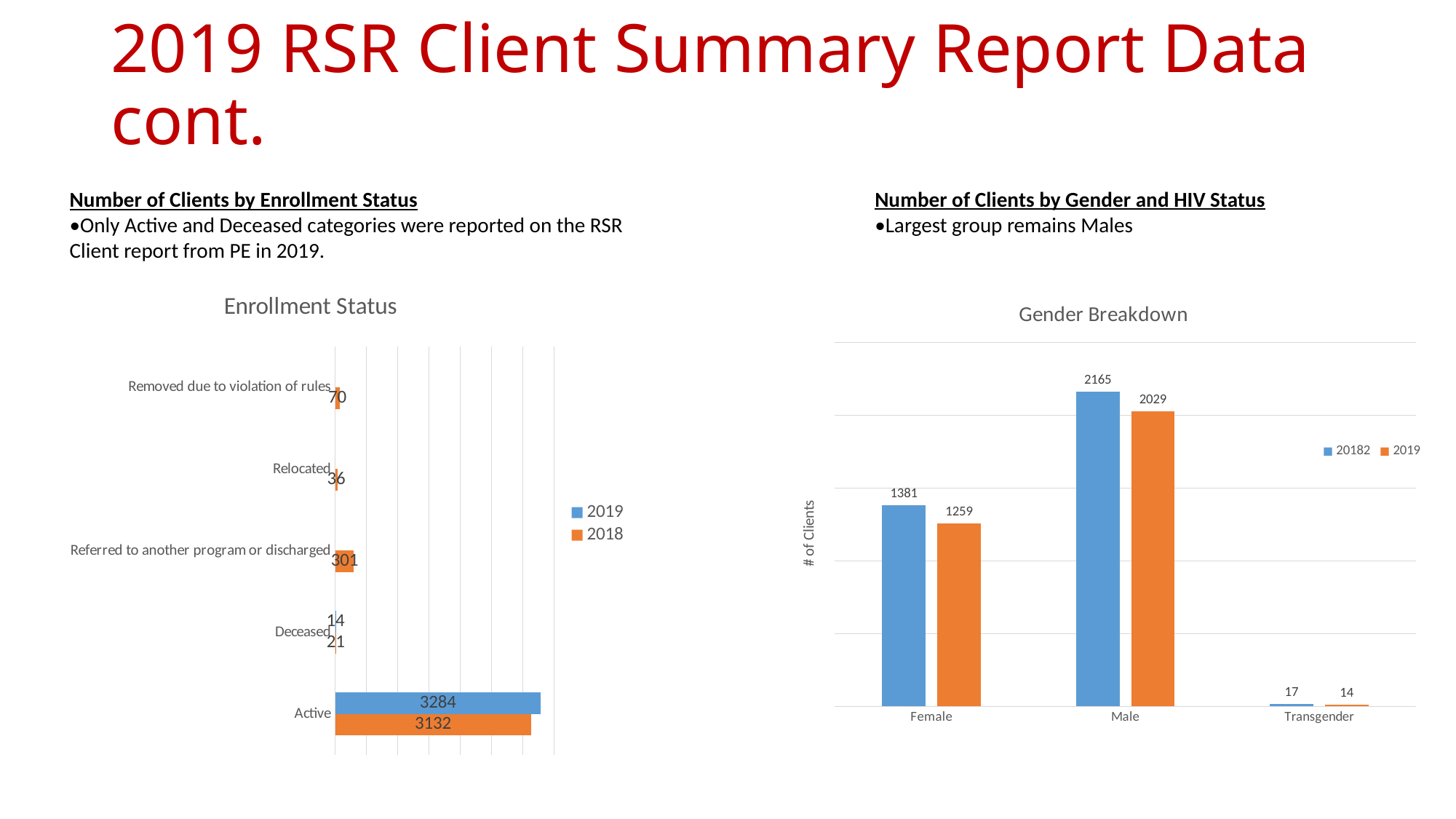
In the Gender Breakdown chart, what is the difference between the two Male values (2165 and 2029)? 136 In the Enrollment Status chart, what is the 2019 value for Active? 3284 In the Gender Breakdown chart, which category has the highest values? Male In the Gender Breakdown chart, what is the 2019 value for Male? 2029 How many categories are shown on the x axis of the Gender Breakdown chart? 3 In the Enrollment Status chart, what is the difference between the 2019 and 2018 values for Active? 152 In the Enrollment Status chart, what is the 2018 value for Active? 3132 In the Enrollment Status chart, what is the 2018 value for Deceased? 21 How many series does the legend of the Enrollment Status chart list? 2 In the Gender Breakdown chart, what is the value for Female in the series labelled 20182? 1381 In the Enrollment Status chart, what is the 2018 value for Referred to another program or discharged? 301 What kind of chart is the Enrollment Status chart? Bar chart